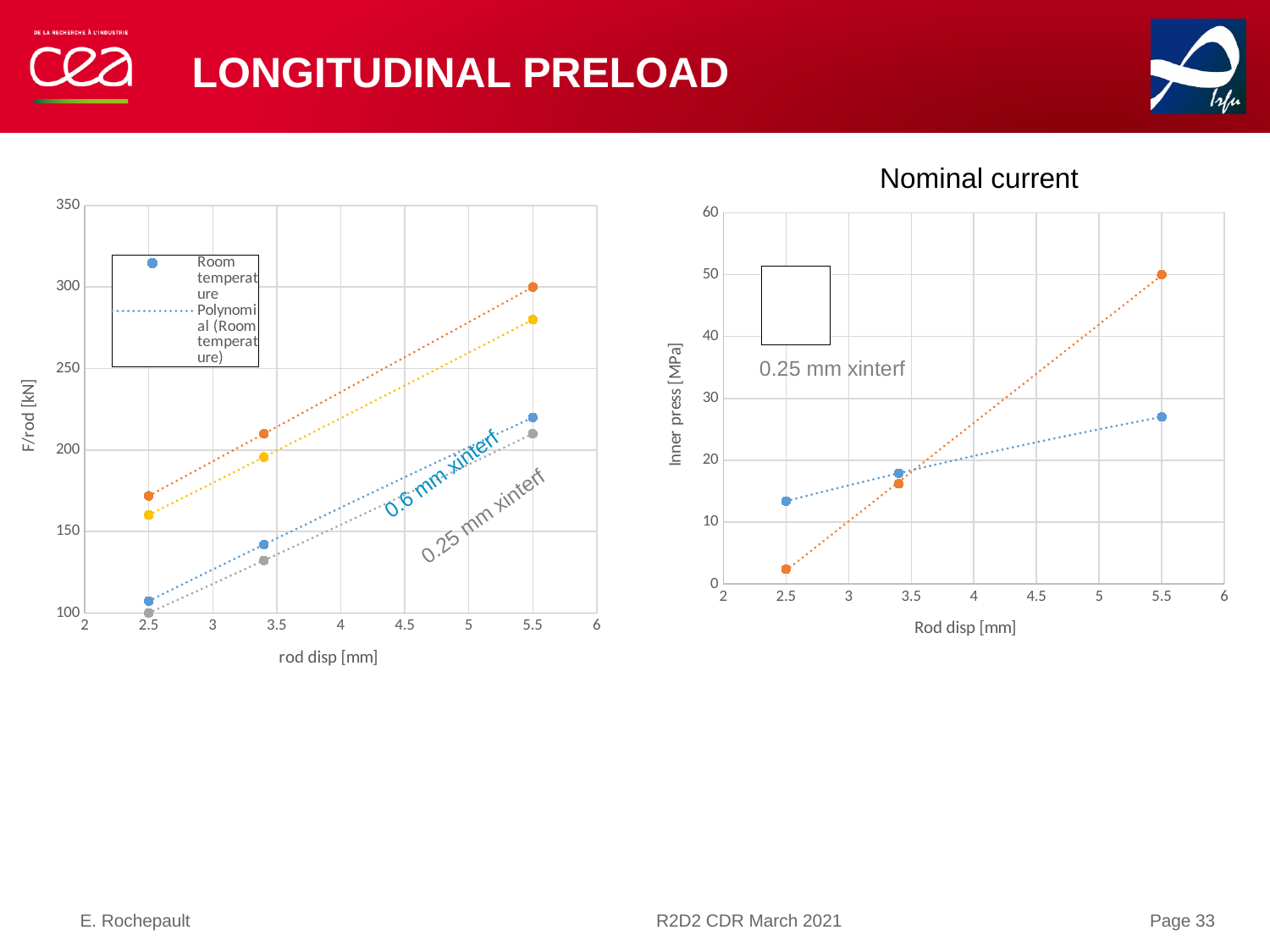
In the left chart, which series has the highest F/rod value at rod disp 5.5? orange In the left chart, is the value of the orange series at rod disp 2.5 greater or less than 150? greater In the right chart (Nominal current), do the values of the orange series rise or fall as rod disp increases? rise In the right chart (Nominal current), how many data points does the orange series have? 3 In the right chart (Nominal current), is the value of the orange series at rod disp 2.5 greater or less than 10? less In the left chart, do the values of the blue series rise or fall as rod disp increases? rise In the right chart (Nominal current), at rod disp 2.5, which series has the larger inner pressure, the orange or the blue one? blue In the left chart, is the value of the yellow series at rod disp 5.5 greater or less than 250? greater In the left chart, what is the label of the y axis? F/rod [kN] In the right chart (Nominal current), at rod disp 5.5, which series has the larger inner pressure, the orange or the blue one? orange What is the title of the chart on the right side of the slide? Nominal current